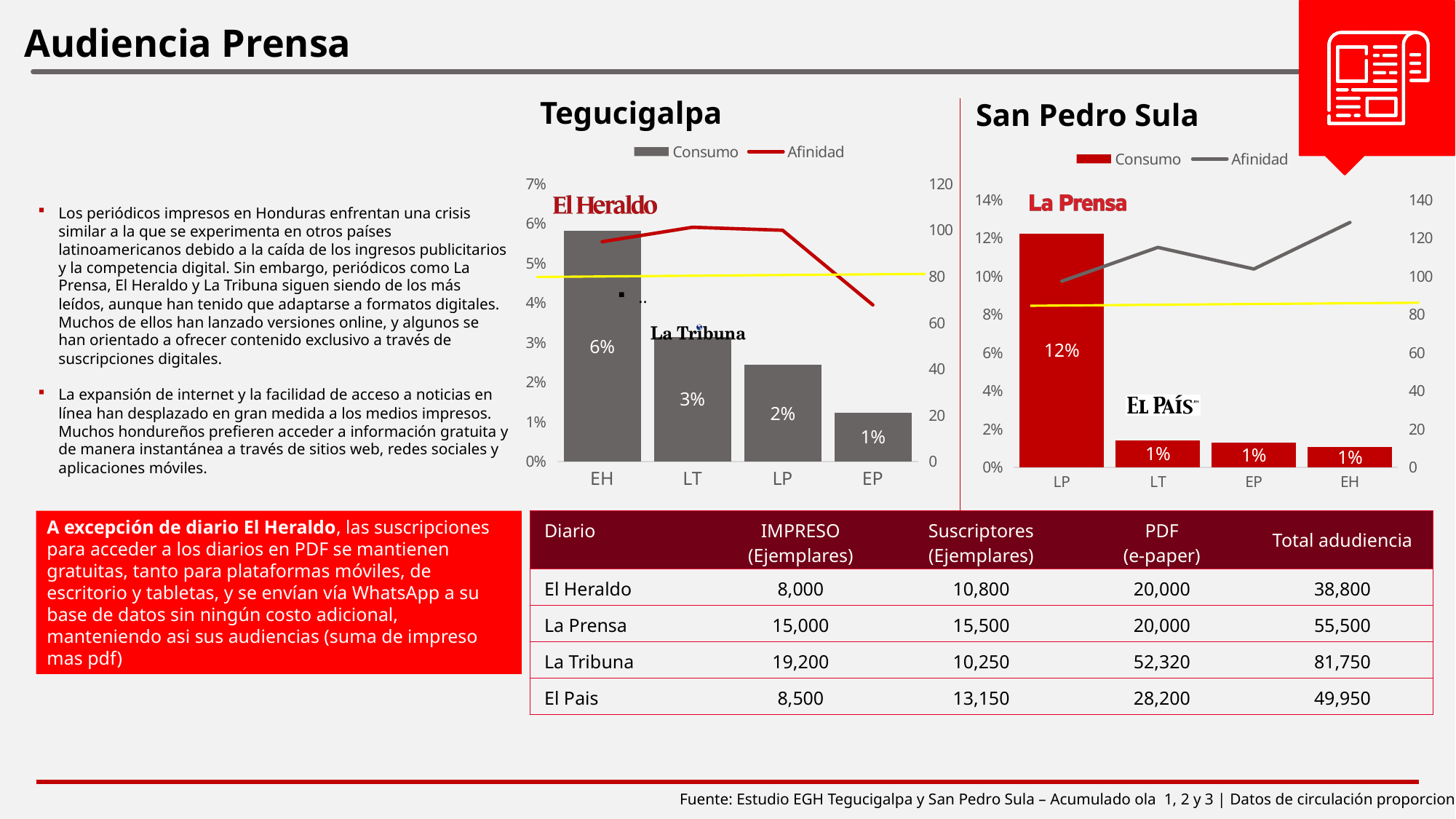
In the Tegucigalpa chart, how many categories are shown on the x axis? 4 In the San Pedro Sula chart, what is the Consumo value for LP? 12% In the Tegucigalpa chart, which category has the highest Consumo value? EH In the Tegucigalpa chart, how many series does the legend list? 2 In the Tegucigalpa chart, what is the difference between the Consumo values for EH and LT? 3% In the Tegucigalpa chart, do the Consumo values rise or fall from EH to EP? fall In the San Pedro Sula chart, which category has the highest Consumo value? LP In the Tegucigalpa chart, is the Afinidad value for EP greater or less than 80? less In the Tegucigalpa chart, which has the larger Consumo value, LT or LP? LT In the San Pedro Sula chart, what is the difference between the Consumo values for LP and LT? 11% In the San Pedro Sula chart, is the Afinidad value for EH greater or less than 120? greater In the Tegucigalpa chart, what is the Consumo value for EH? 6%